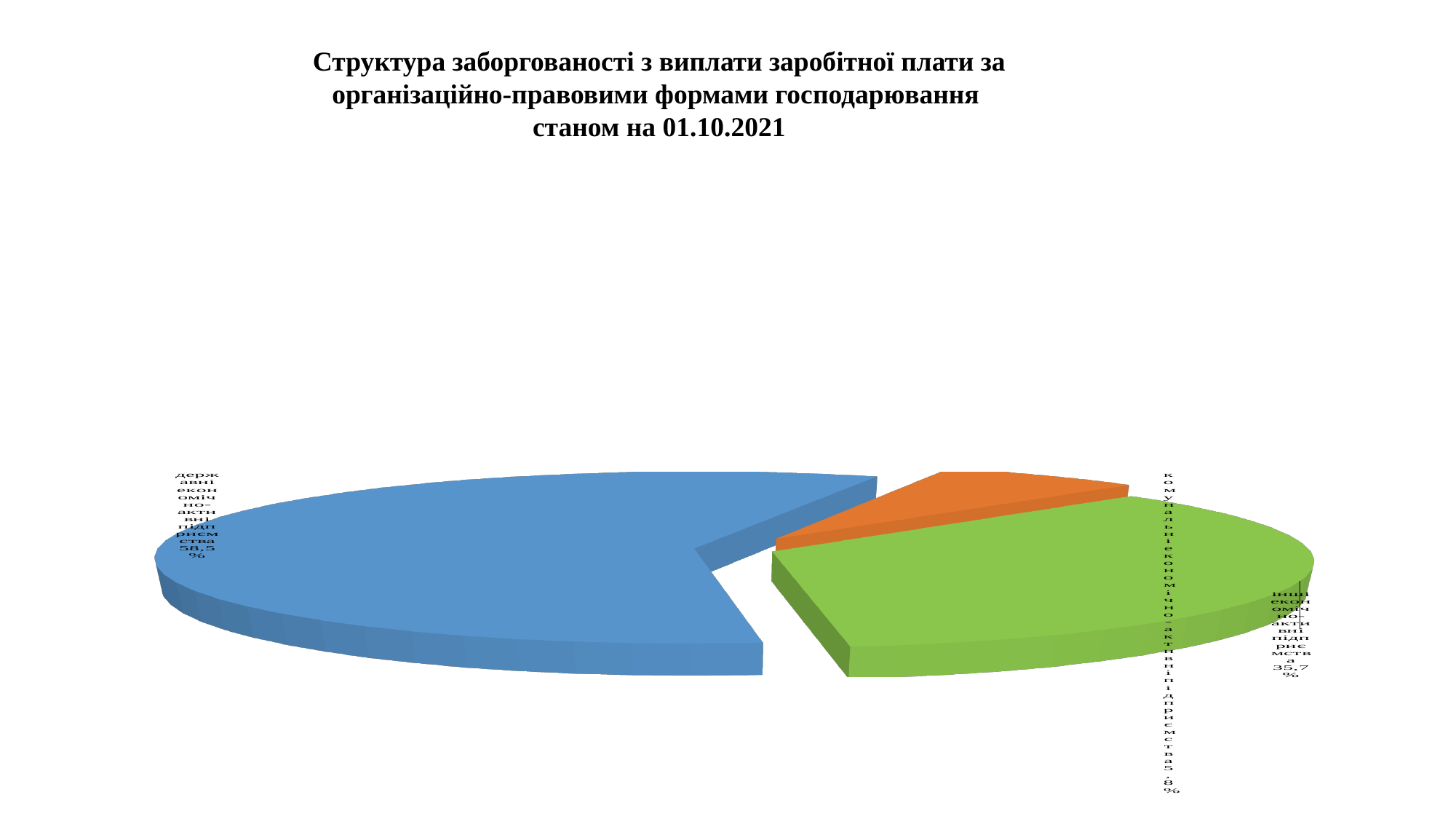
What is the difference in percentage points between the share for інші економічно-активні підприємства and the share for комунальні економічно-активні підприємства? 29,9 What share of the pie is labelled for державні економічно-активні підприємства? 58,5% What date is given in the chart title? 01.10.2021 What share of the pie is labelled for інші економічно-активні підприємства? 35,7% What is the difference in percentage points between the share for державні економічно-активні підприємства and the share for інші економічно-активні підприємства? 22,8 Which category has the smallest share of the pie? комунальні економічно-активні підприємства What kind of chart is shown on the slide? pie chart What colour is the slice for державні економічно-активні підприємства? blue Which category has the largest share of the pie? державні економічно-активні підприємства How many slices does the pie chart have? 3 What share of the pie is labelled for комунальні економічно-активні підприємства? 5,8% Which is larger: the share for державні економічно-активні підприємства or for інші економічно-активні підприємства? державні економічно-активні підприємства